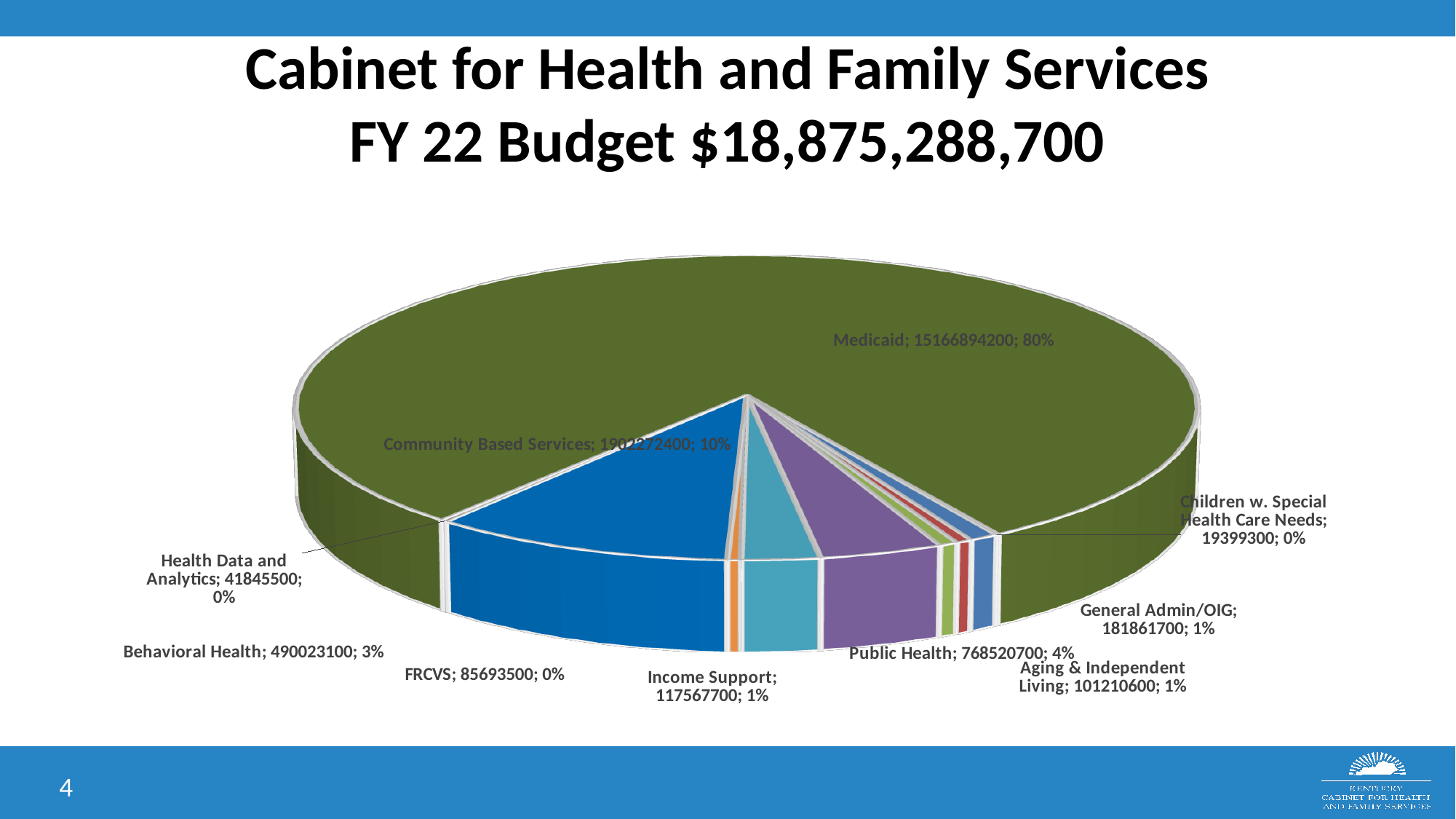
What total FY 22 budget is stated in the slide title? $18,875,288,700 What is the difference between the Medicaid value and the Community Based Services value? 13264621800 Which category has the largest slice of the pie? Medicaid What share of the pie does Community Based Services represent? 10% Which is larger, the value for Public Health or the value for Behavioral Health? Public Health How many categories (slices) are shown in the pie chart? 10 What is the budget value shown for Medicaid? 15166894200 What kind of chart is shown on the slide? Pie chart What percentage share is shown for Behavioral Health? 3% What is the value shown for FRCVS? 85693500 What is the value shown for Public Health? 768520700 Which category has the smallest value in the pie chart? Children w. Special Health Care Needs